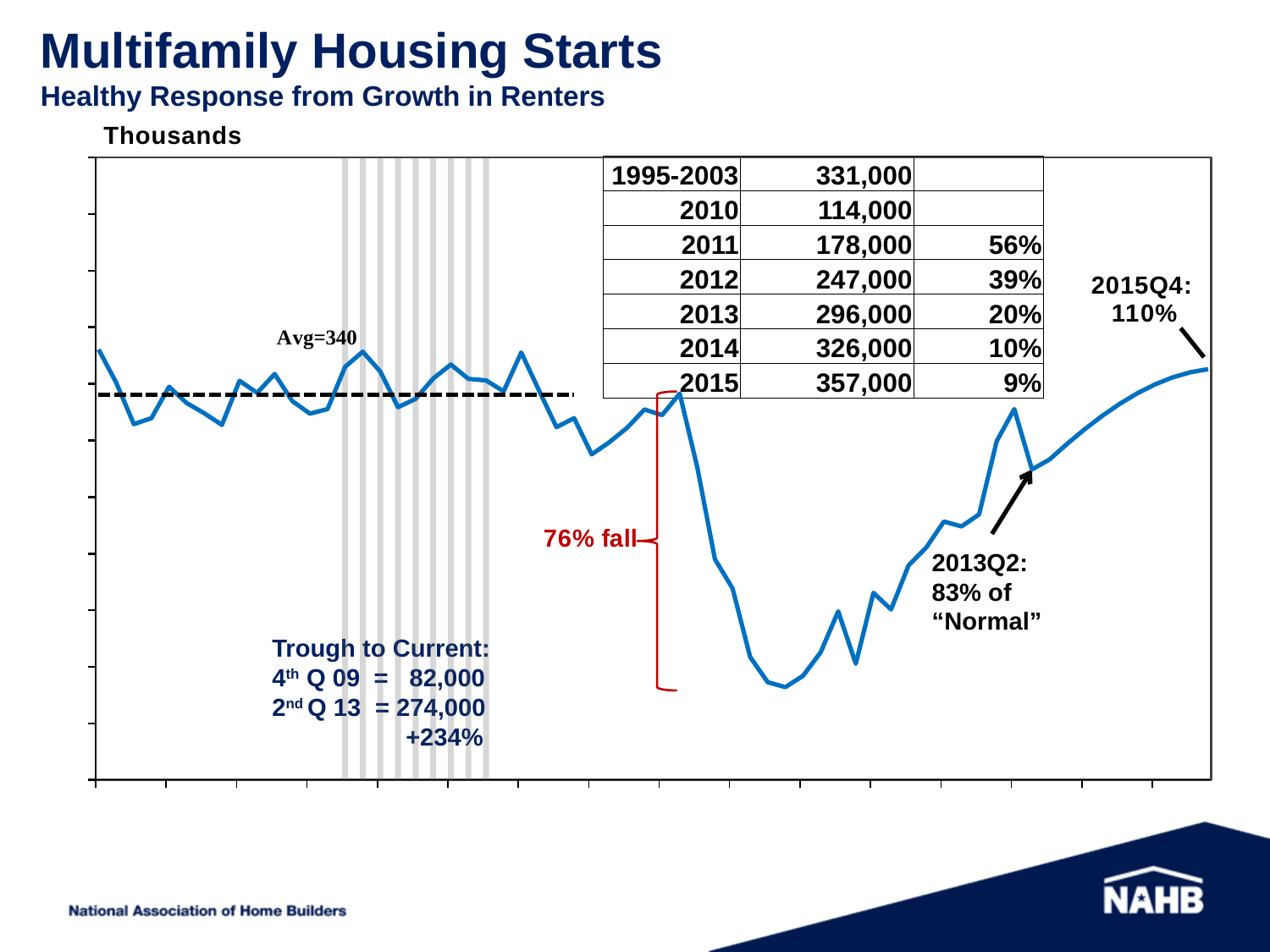
Which is larger in the table, the value for 2012 or the value for 2013? 2013 What kind of chart is shown on the slide? line chart According to the table on the chart, what was the value for the 1995-2003 period? 331,000 What value does the annotation give for the trough in the 4th quarter of 2009? 82,000 What is the title of the chart on the slide? Multifamily Housing Starts What percentage fall does the red annotation on the chart indicate? 76% fall According to the table on the chart, what was the percentage change shown for 2011? 56% Among the years 2010 to 2015 in the table, which year has the lowest value? 2010 According to the table on the chart, what was the value for 2010? 114,000 Among the years 2010 to 2015 in the table, which year has the highest value? 2015 In what units are the values on the chart expressed, according to the axis label? Thousands What is the difference between the table values for 2015 and 2014? 31,000